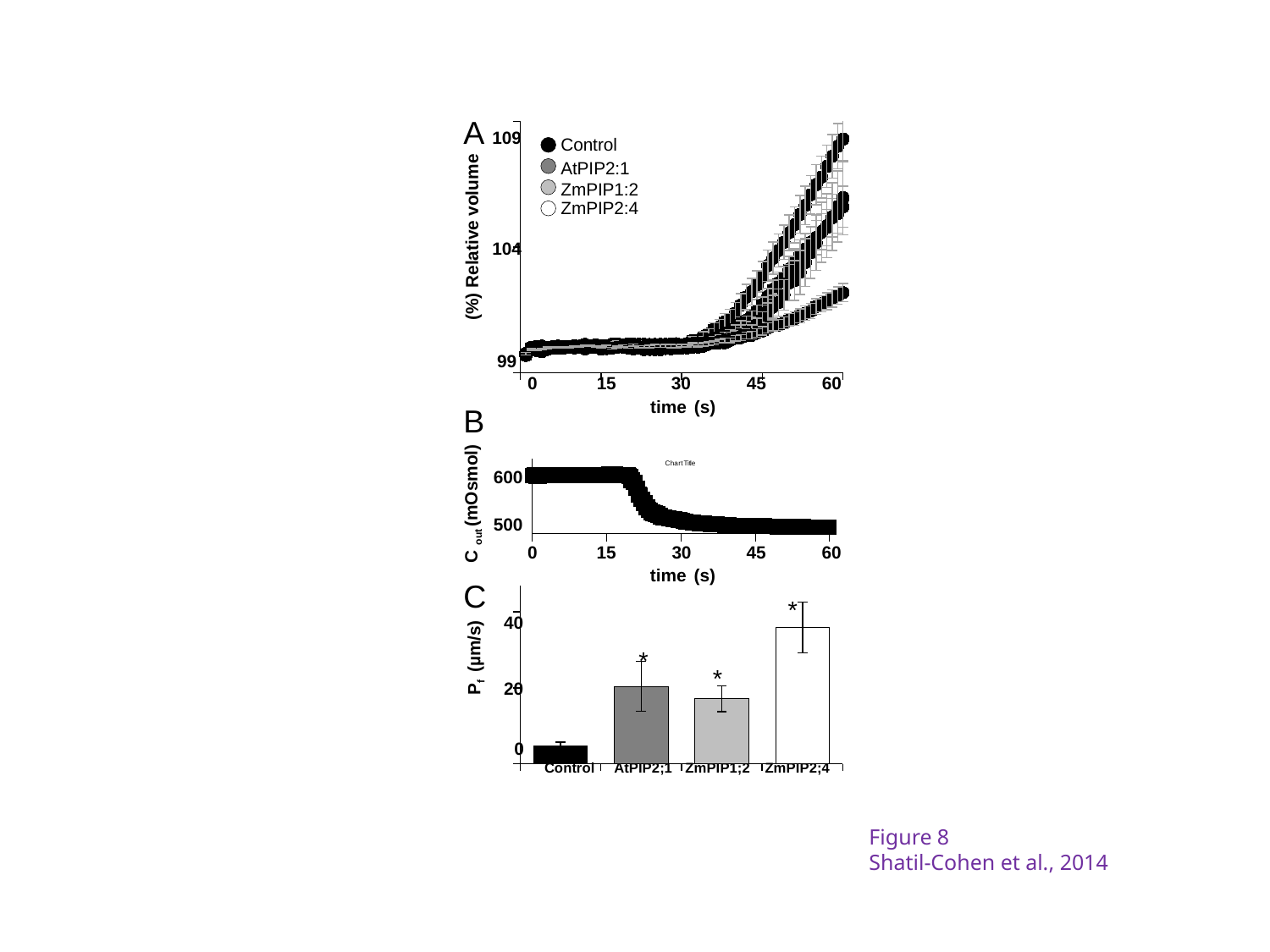
In chart C (the bottom chart), is the value for Control greater or less than 20? less In chart C (the bottom chart), is the value for ZmPIP2;4 greater or less than 20? greater In chart C (the bottom chart), which category has the lowest Pf value? Control In chart B (the middle chart), is the C out value at 60 s greater or less than 600? less In chart C (the bottom chart), which is larger, the value for ZmPIP2;4 or the value for AtPIP2;1? ZmPIP2;4 In chart C (the bottom chart), how many categories are shown on the x axis? 4 In chart B (the middle chart), does C out rise or fall as time increases from 15 s to 30 s? fall In chart C (the bottom chart), which category has the highest Pf value? ZmPIP2;4 In chart A (the top chart), do the relative volume values rise or fall as time increases from 30 s to 60 s? rise What kind of chart is chart C (the bottom chart)? bar chart In chart A (the top chart), how many series does the legend list? 4